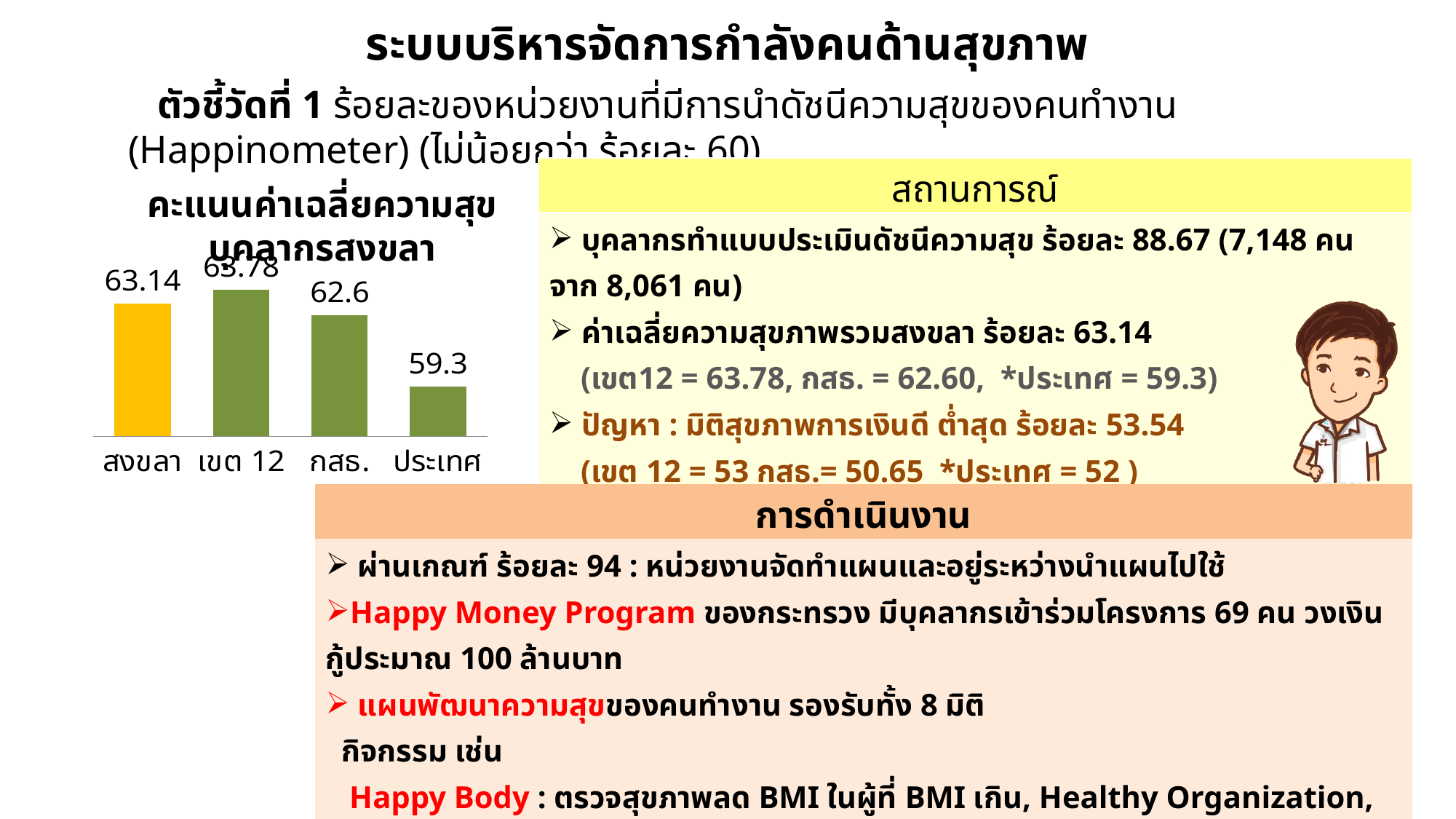
Which bar in the chart is coloured differently (yellow) from the others? สงขลา Which category has the highest value in the chart? เขต 12 What is the value for เขต 12 in the chart? 63.78 What is the difference between the values for สงขลา and กสธ.? 0.54 What is the value for สงขลา in the chart? 63.14 What is the difference between the values for เขต 12 and ประเทศ? 4.48 What kind of chart is shown on the slide? Bar chart How many categories are shown in the chart? 4 Which is larger, the value for กสธ. or the value for ประเทศ? กสธ. Which category has the lowest value in the chart? ประเทศ What is the value for ประเทศ in the chart? 59.3 What is the value for กสธ. in the chart? 62.6